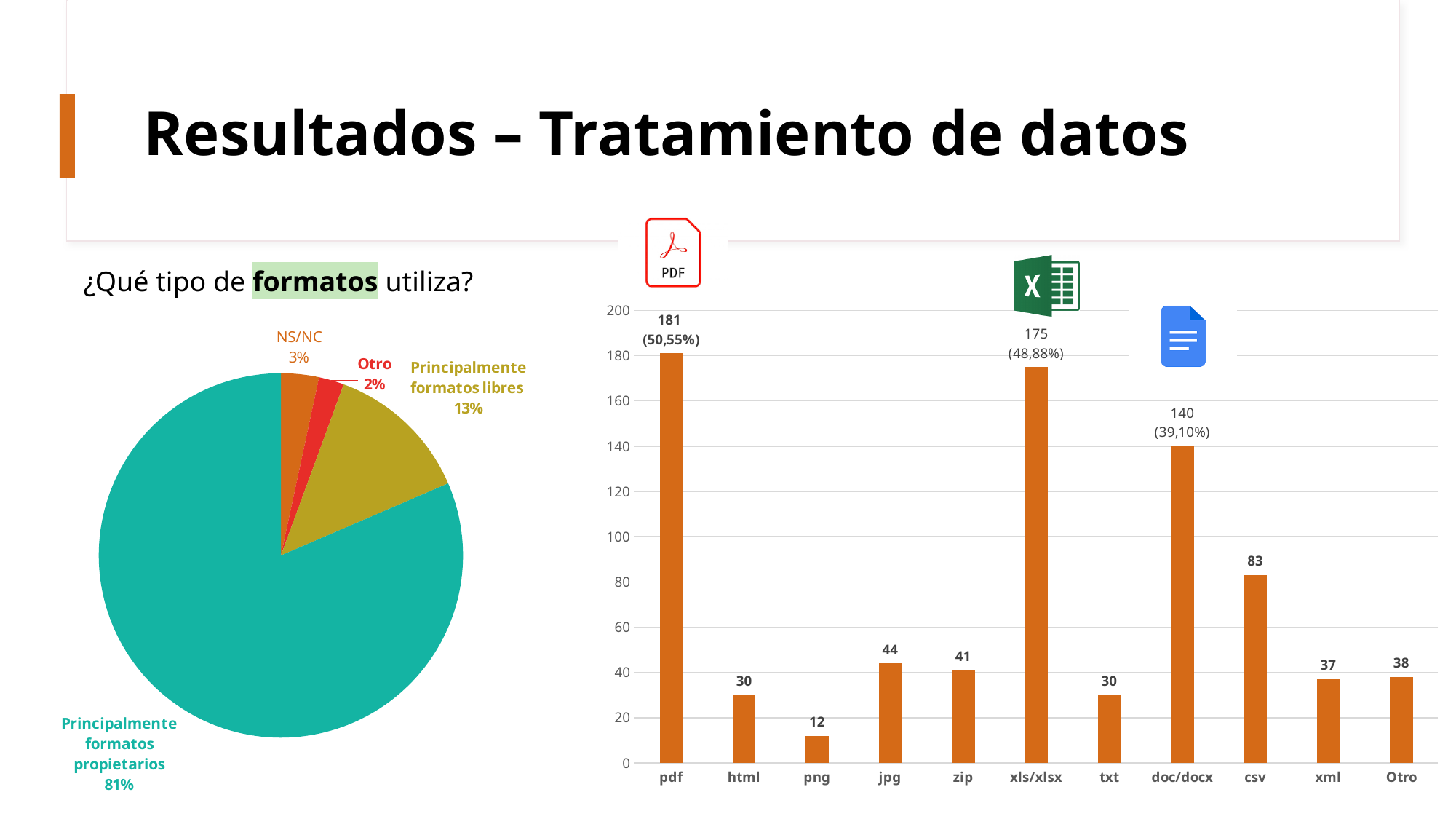
In the bar chart on the right, how many formats are shown on the x axis? 11 In the bar chart on the right, what is the value for pdf? 181 In the pie chart on the left, what share is labelled for 'Principalmente formatos libres'? 13% In the bar chart on the right, which is larger, the value for csv or the value for jpg? csv In the bar chart on the right, what is the difference between the values for pdf and xls/xlsx? 6 What kind of chart is the chart on the right side of the slide? Bar chart In the pie chart on the left, which category has the smallest slice? Otro In the pie chart on the left, what share is labelled for 'Principalmente formatos propietarios'? 81% In the pie chart on the left, how many slices are there? 4 In the bar chart on the right, which format has the highest value? pdf In the bar chart on the right, what is the value for doc/docx? 140 In the bar chart on the right, which format has the lowest value? png